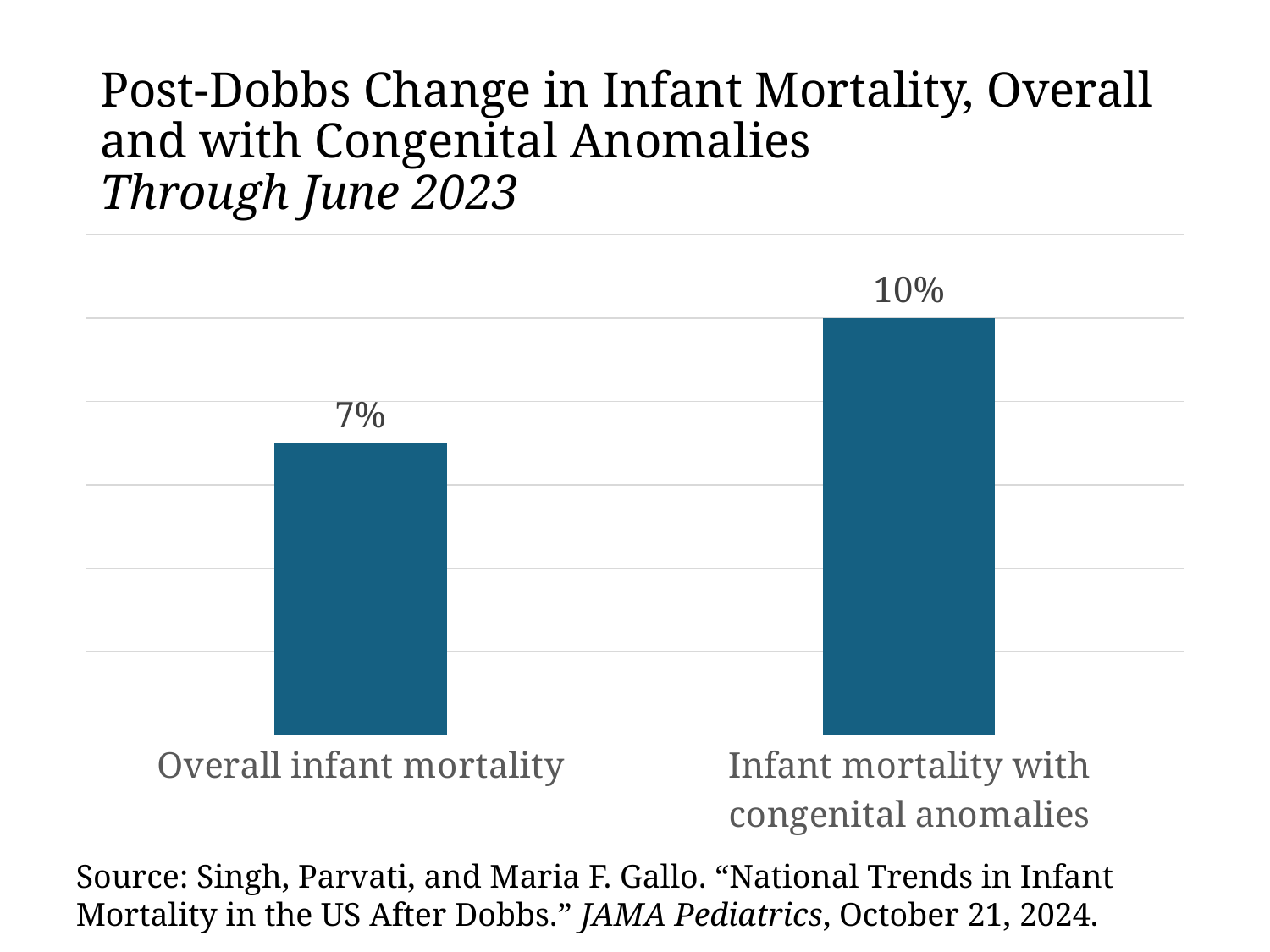
What is the difference between the value for Infant mortality with congenital anomalies and the value for Overall infant mortality? 3% What is the value for Overall infant mortality? 7% What is the value for Infant mortality with congenital anomalies? 10% Which category has the highest value? Infant mortality with congenital anomalies What time period does the chart subtitle say the data covers? Through June 2023 Which category has the lowest value? Overall infant mortality What kind of chart is shown on the slide? Bar chart What is the title of the chart? Post-Dobbs Change in Infant Mortality, Overall and with Congenital Anomalies Which is larger: the value for Overall infant mortality or the value for Infant mortality with congenital anomalies? Infant mortality with congenital anomalies How many categories are shown in the chart? 2